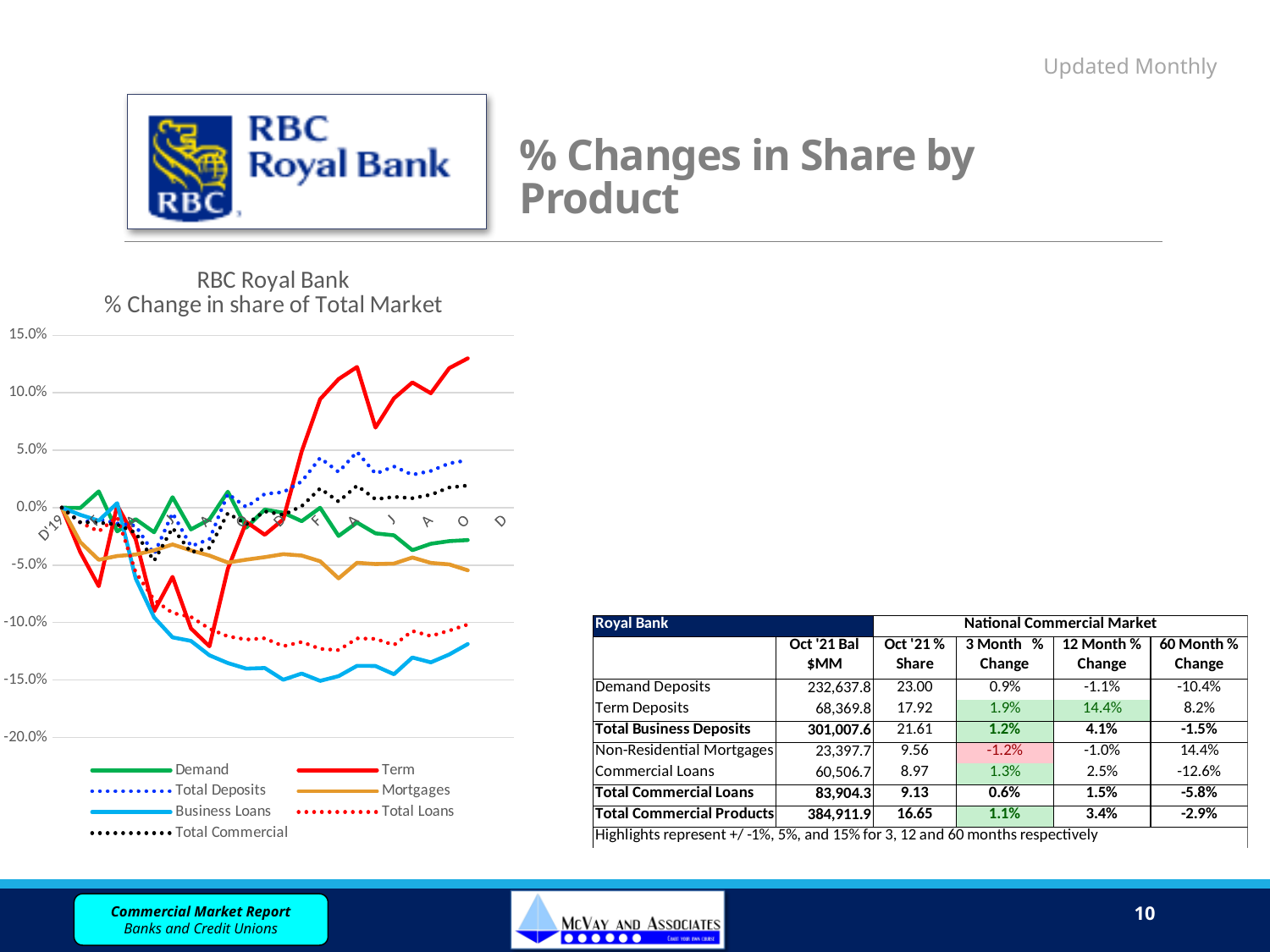
Is the final value of the Mortgages series greater or less than 0.0%? less What is the title of the chart? RBC Royal Bank % Change in share of Total Market Which series has the highest value at the right end of the chart? Term At the right end of the chart, which is larger: the Term series or the Business Loans series? Term Is the final value of the Business Loans series greater or less than -10.0%? less Is the final value of the Term series greater or less than 10.0%? greater Which series is drawn as a solid red line? Term How many series does the chart legend list? 7 Does the Business Loans series overall rise or fall from the start of the chart to the end? fall Which series has the lowest value at the right end of the chart? Business Loans Does the Term series overall rise or fall from the start of the chart to the end? rise What kind of chart is shown on the slide? line chart